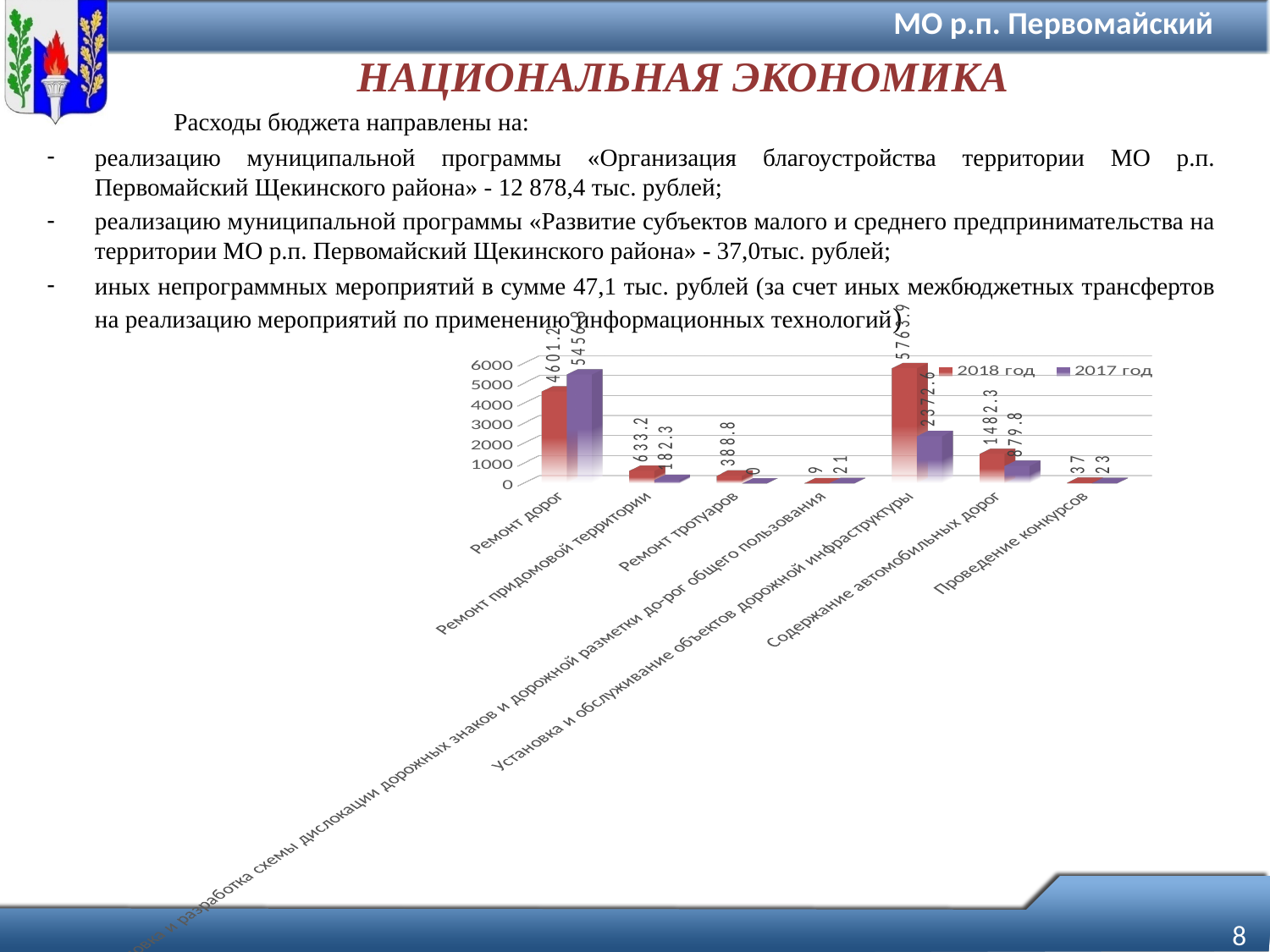
What is the value for 'Содержание автомобильных дорог' in the '2018 год' series? 1482.3 Is the '2017 год' value for 'Ремонт дорог' greater or less than 5000? greater What is the value for 'Ремонт дорог' in the '2018 год' series? 4601.2 What type of chart is shown on the slide? bar chart How many series does the chart legend list? 2 What is the value for 'Проведение конкурсов' in the '2017 год' series? 23 Which category has the lowest value in the '2017 год' series? Ремонт тротуаров For 'Ремонт придомовой территории', which series has the larger value, '2018 год' or '2017 год'? 2018 год How many categories are plotted on the chart's x axis? 7 What is the difference between the '2018 год' and '2017 год' values for 'Содержание автомобильных дорог'? 602.5 Which category has the highest value in the '2017 год' series? Ремонт дорог What is the value for 'Ремонт придомовой территории' in the '2017 год' series? 182.3